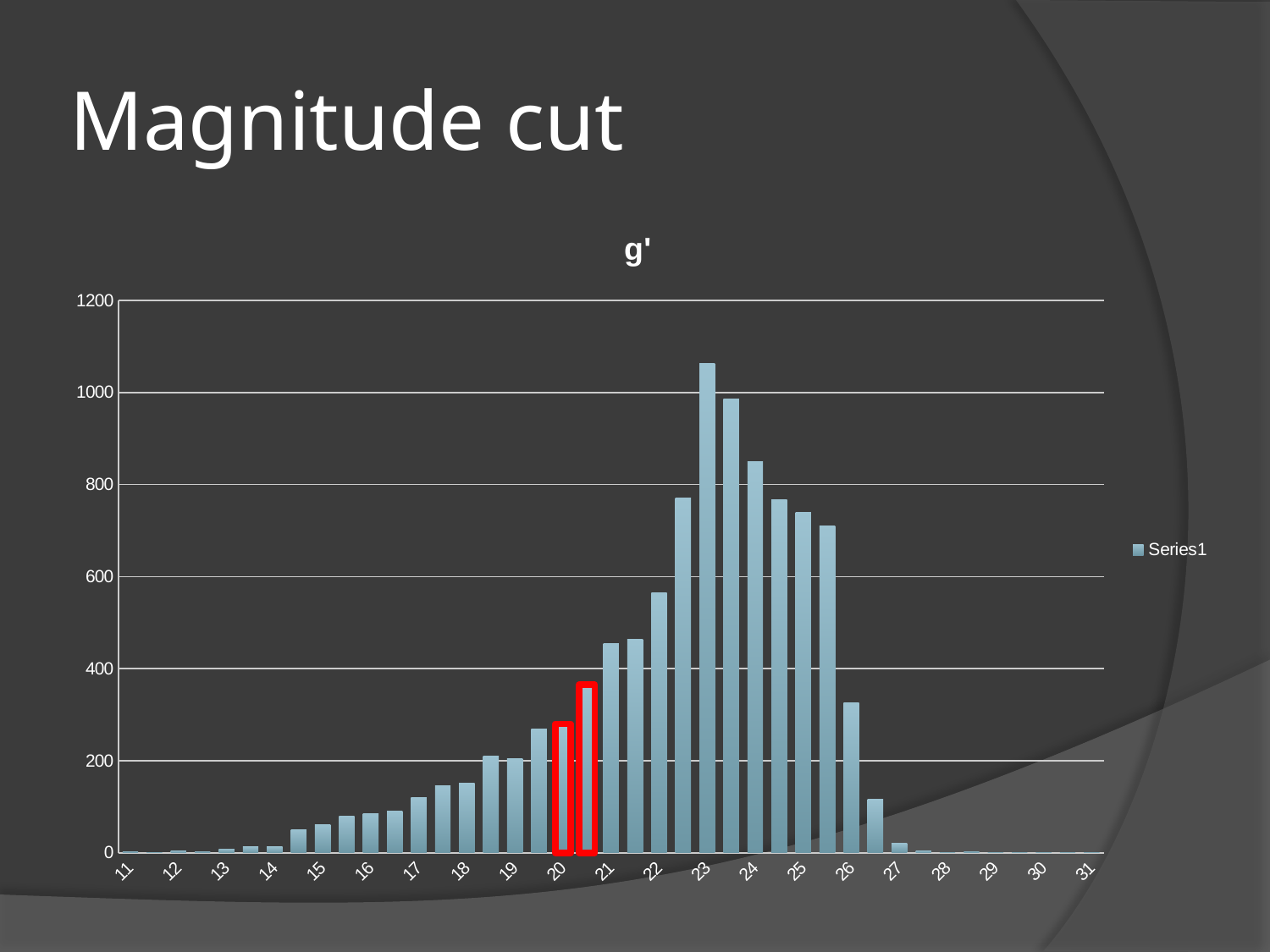
Which bar is taller, the one at 20 or the one at 21? 21 What is the title of the chart? g' What kind of chart is shown on the slide? bar chart Is the value of the bar at 18 greater or less than 200? less Is the value of the bar at 23 greater or less than 1000? greater What is the name of the series shown in the legend? Series1 Do the bar values rise or fall from 11 to 23 along the x axis? rise Is the value of the bar at 26 greater or less than 400? less Which bar is taller, the one at 22 or the one at 26? 22 How many series does the legend list? 1 Which labelled x-axis value has the tallest bar? 23